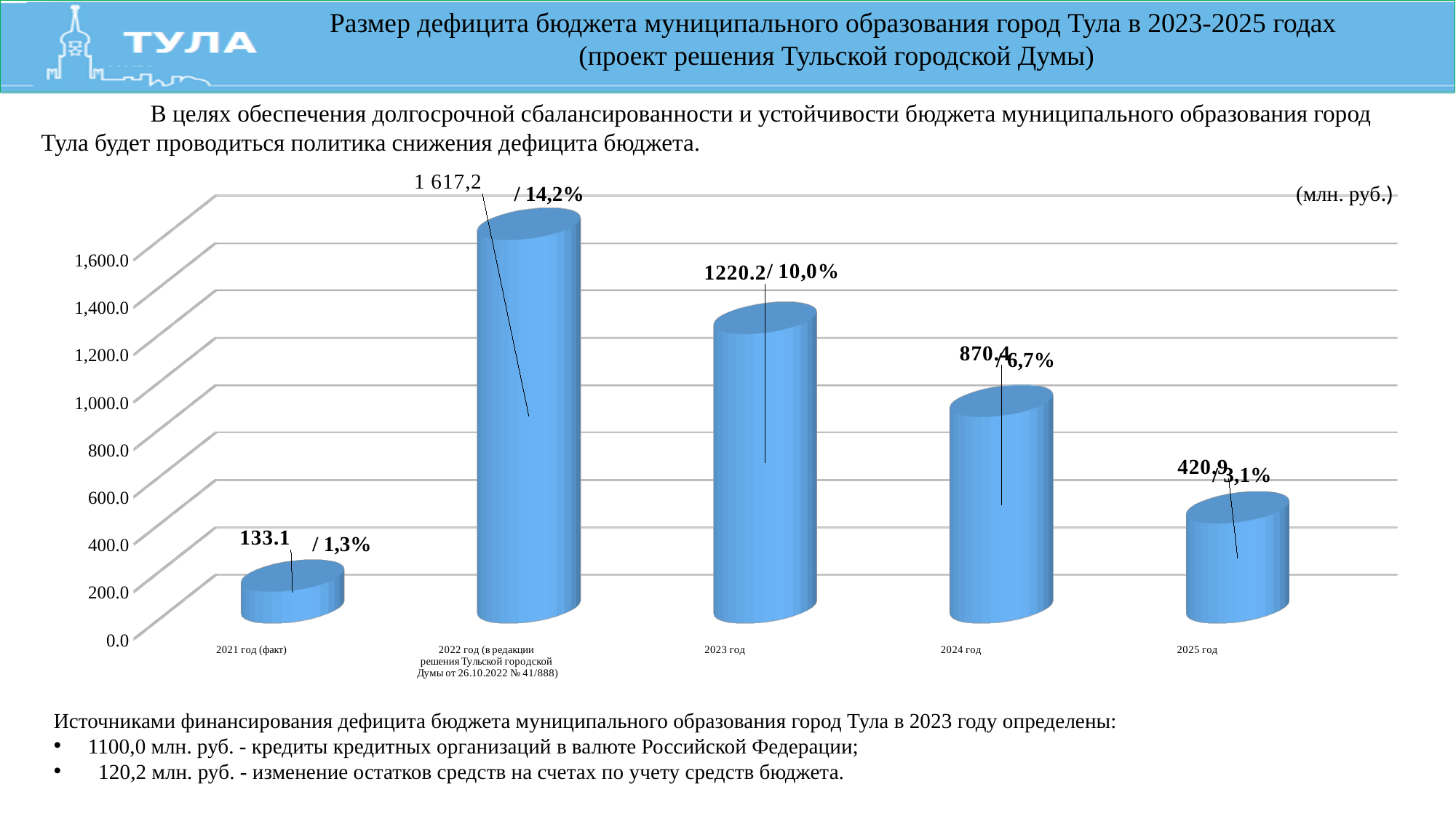
Which year has the lowest budget deficit value? 2021 год (факт) What is the budget deficit value shown for 2023 год? 1220.2 What is the difference between the values for 2024 год and 2025 год? 449,5 Which year has the highest budget deficit value? 2022 год From 2022 год to 2025 год, do the values rise or fall? fall What is the budget deficit value shown for 2025 год? 420,9 What percentage is shown next to the 2022 год bar? 14,2% How many years (categories) are plotted on the chart? 5 What is the budget deficit value shown for 2021 год (факт)? 133.1 What kind of chart is shown on the slide? bar chart Which is larger, the value for 2023 год or the value for 2024 год? 2023 год What percentage is shown next to the 2024 год bar? 6,7%